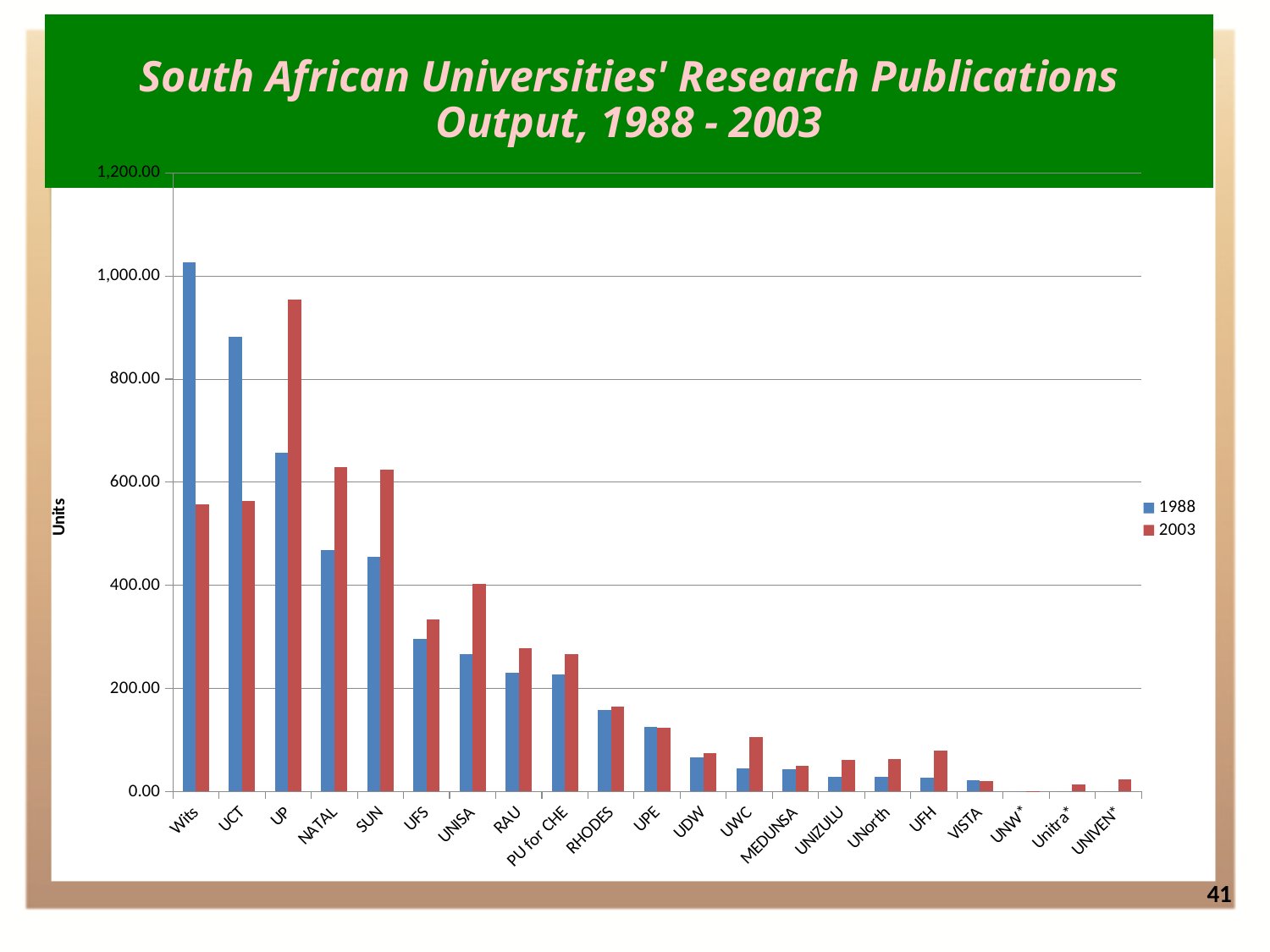
Is the 1988 value for Wits greater or less than 800? greater Which university has the highest value for 1988? Wits For UP, which is larger: the 1988 value or the 2003 value? 2003 Is the 1988 value for UFS greater or less than 400? less Is the 2003 value for UCT greater or less than 600? less Which university has the highest value for 2003? UP What kind of chart is shown on the slide? bar chart How many universities are shown along the x axis? 21 How many series does the legend list? 2 For Wits, which is larger: the 1988 value or the 2003 value? 1988 What is the label on the vertical axis? Units